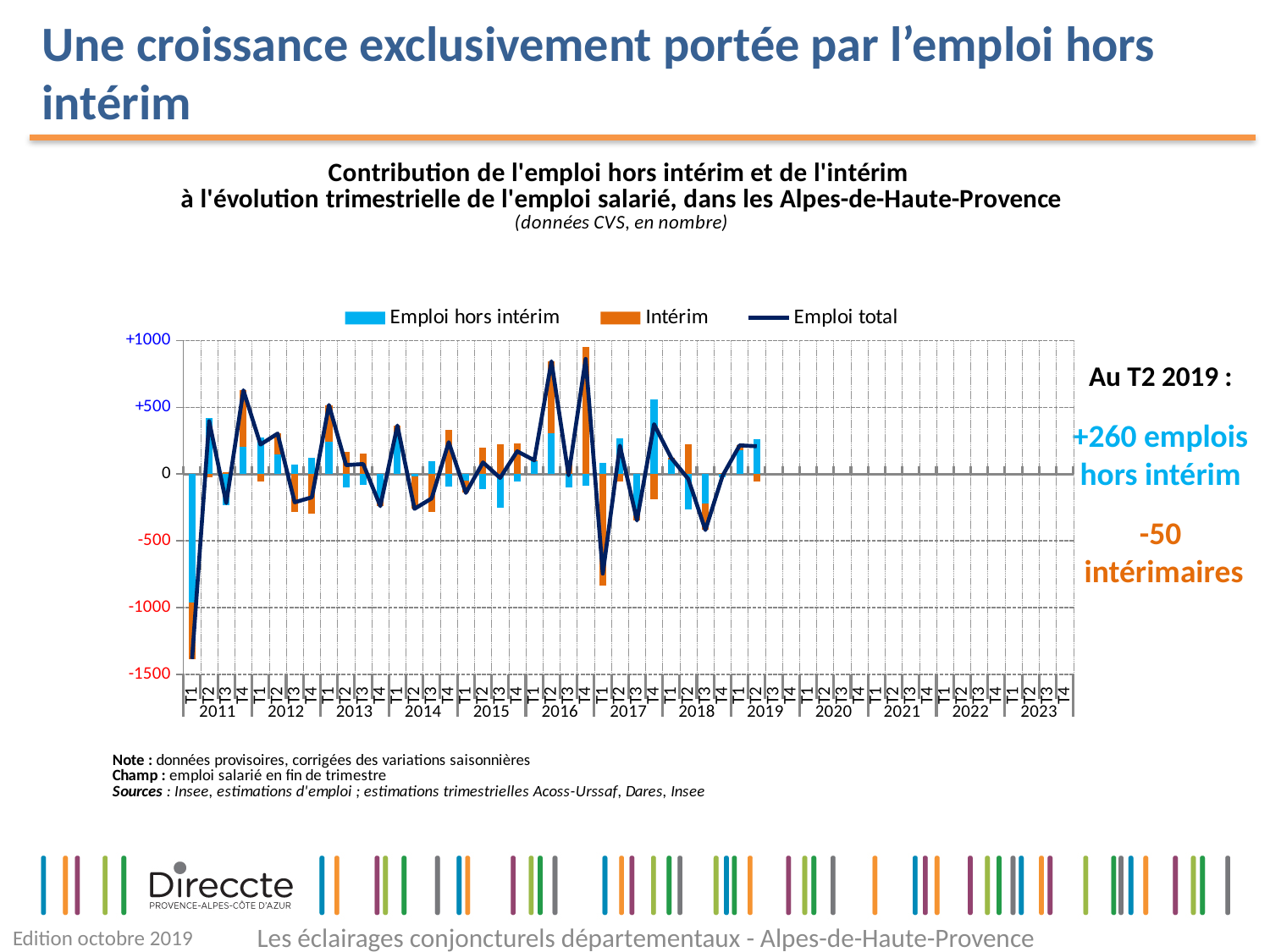
At T2 2019, which is larger, the value for Emploi hors intérim or the value for Intérim? Emploi hors intérim Which colour represents the Intérim series in the chart? Orange According to the annotation, what is the value for Emploi hors intérim at T2 2019? +260 In which quarter does the Emploi total line reach its lowest point? T1 2011 How many series does the chart legend list? 3 Is the value of Emploi total at T2 2016 greater or less than +500? greater What kind of chart is shown on the slide? A combined bar and line chart Is the value of Emploi total at T1 2011 greater or less than -1000? less Is the value of Emploi total at T1 2017 greater or less than -500? less According to the annotation, what is the value for Intérim at T2 2019? -50 How many years are labelled along the x axis of the chart? 13 What is the difference between the Emploi hors intérim value (+260) and the Intérim value (-50) at T2 2019? 310